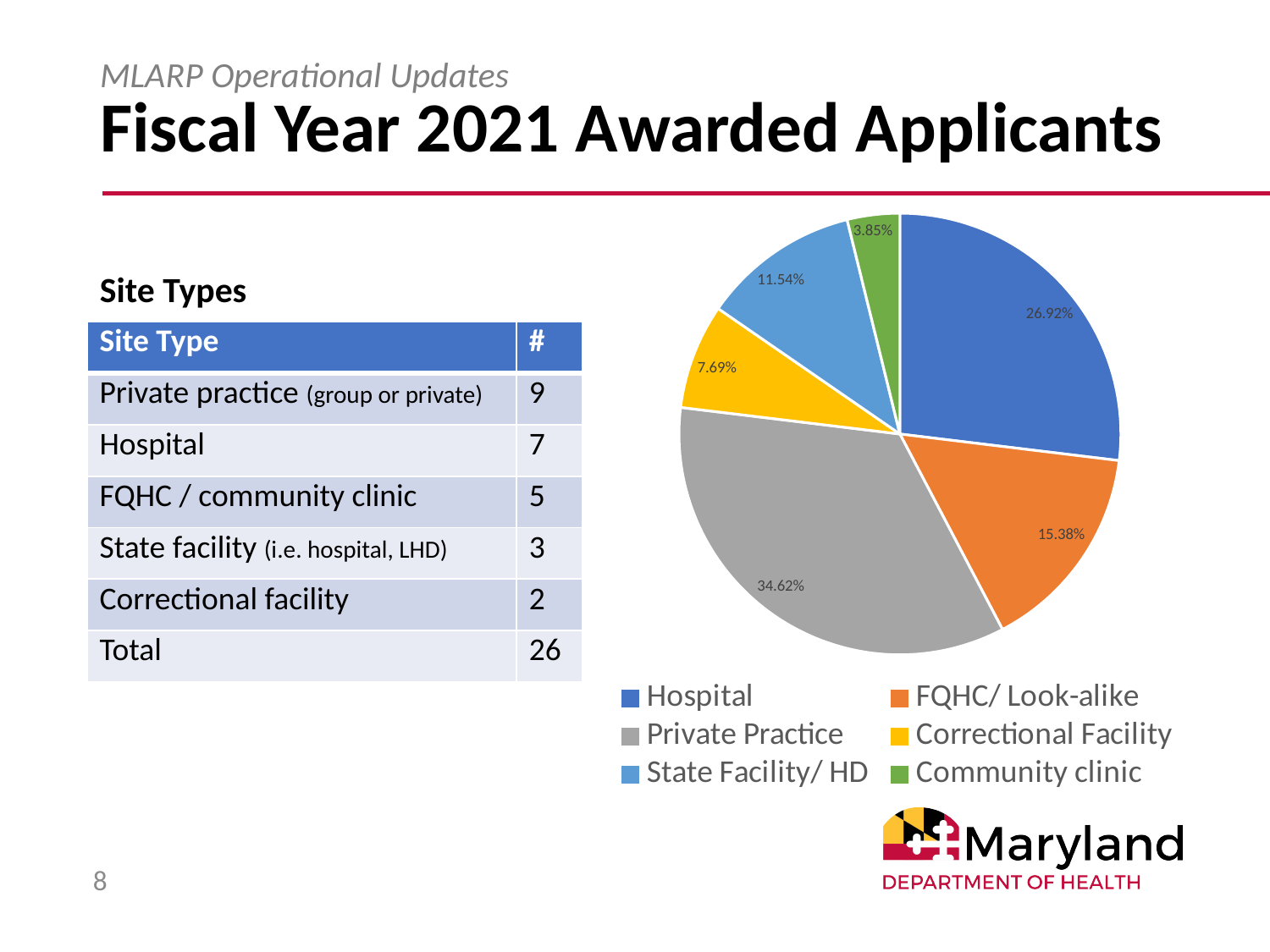
What share of the pie does Private Practice represent? 34.62% What colour is the Hospital slice in the pie chart? blue Which slice is larger in the pie chart, Correctional Facility or State Facility/ HD? State Facility/ HD How many slices does the pie chart have? 6 How many entries does the pie chart's legend list? 6 What percentage is shown for FQHC/ Look-alike in the pie chart? 15.38% What percentage is shown for State Facility/ HD in the pie chart? 11.54% What kind of chart is shown on the slide? pie chart What share of the pie does Hospital represent? 26.92% Which category has the smallest slice in the pie chart? Community clinic What percentage is shown for Community clinic in the pie chart? 3.85% Which category has the largest slice in the pie chart? Private Practice